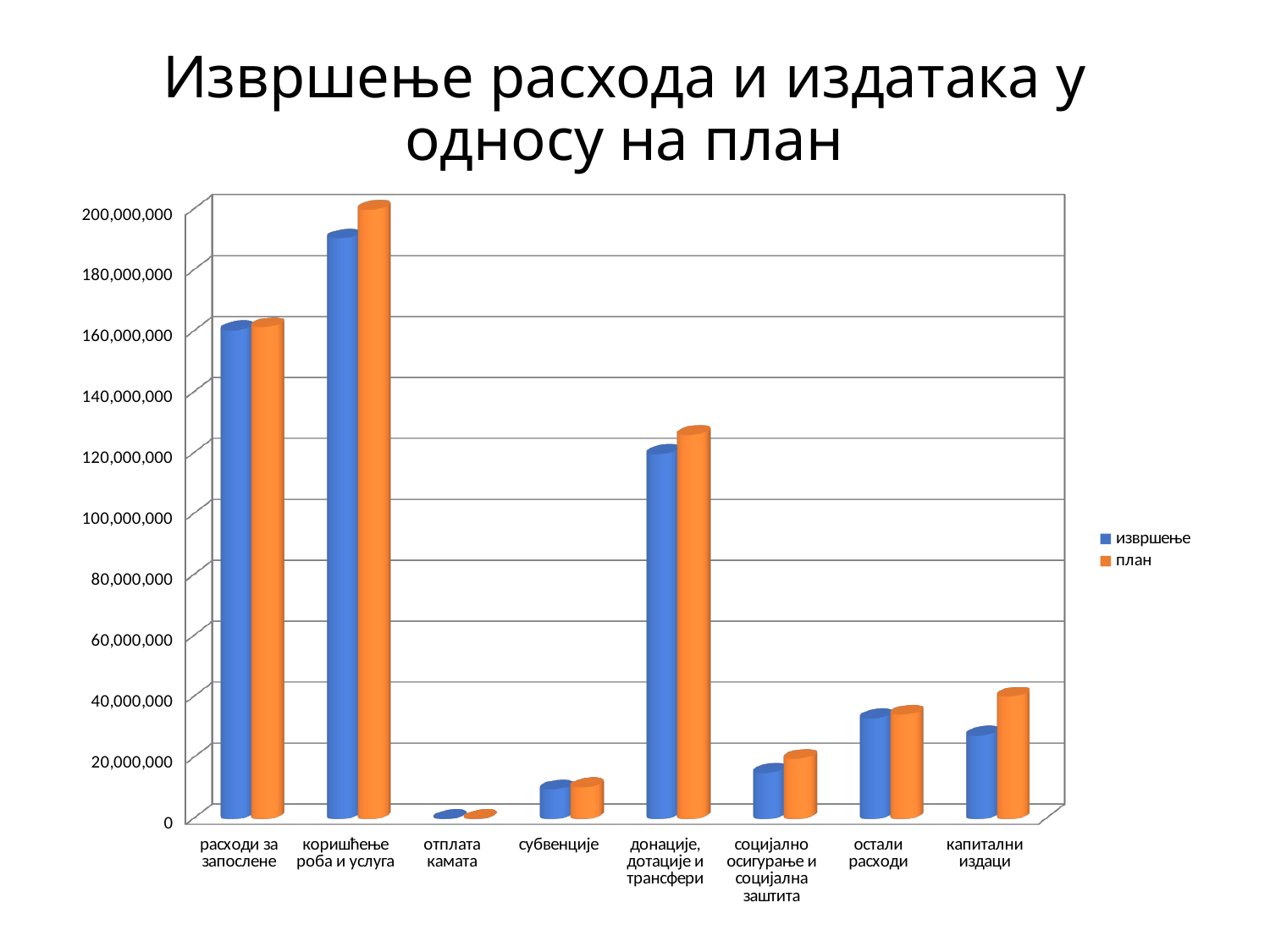
For коришћење роба и услуга, which is larger: извршење or план? план For капитални издаци, which is larger: извршење or план? план Is the извршење value for остали расходи greater or less than 40,000,000? less What kind of chart is shown on the slide? bar chart Is the извршење value for коришћење роба и услуга greater or less than 180,000,000? greater Which category has the highest value for the план series? коришћење роба и услуга How many categories are shown on the x axis? 8 Is the план value for субвенције greater or less than 20,000,000? less Which category has the lowest value for the извршење series? отплата камата Which colour represents the план series in the legend? orange How many series does the legend list? 2